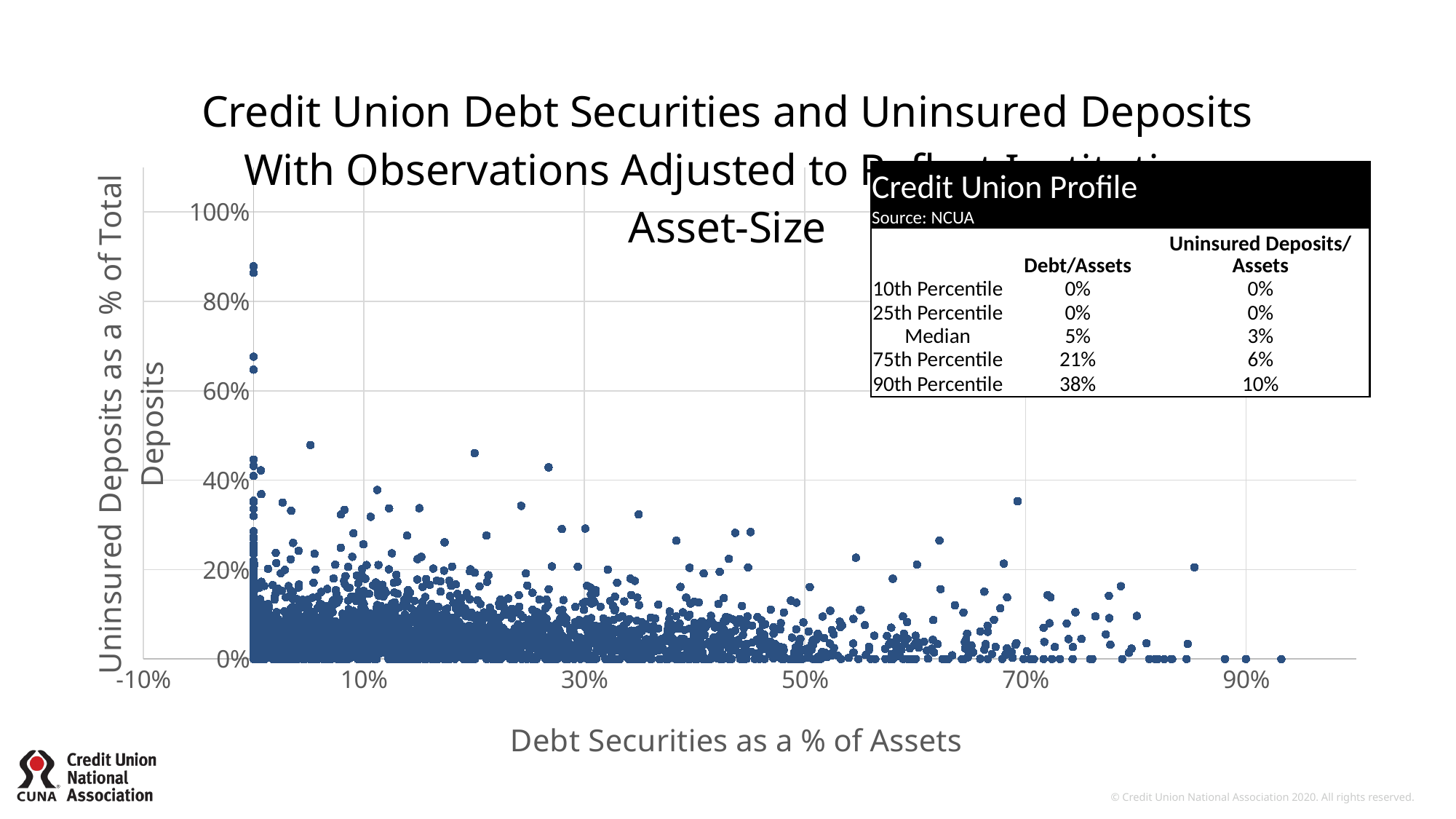
Is the highest point on the chart greater or less than 80% on the y axis? greater What is the title of the y axis of the chart? Uninsured Deposits as a % of Total Deposits In the Credit Union Profile table, what is the 75th percentile value for Debt/Assets? 21% In the Credit Union Profile table, what is the median Uninsured Deposits/Assets value? 3% What is the title of the x axis of the chart? Debt Securities as a % of Assets In the Credit Union Profile table, which is larger at the 90th percentile: Debt/Assets or Uninsured Deposits/Assets? Debt/Assets In the Credit Union Profile table, what is the difference between the 90th percentile and 75th percentile Debt/Assets values? 17% In the Credit Union Profile table, what is the 90th percentile value for Uninsured Deposits/Assets? 10% Do the points with the highest uninsured deposit values occur at low or high debt securities values? low In the Credit Union Profile table, what is the median Debt/Assets value? 5% What kind of chart is shown on the slide? scatter plot What source is cited for the Credit Union Profile table? NCUA